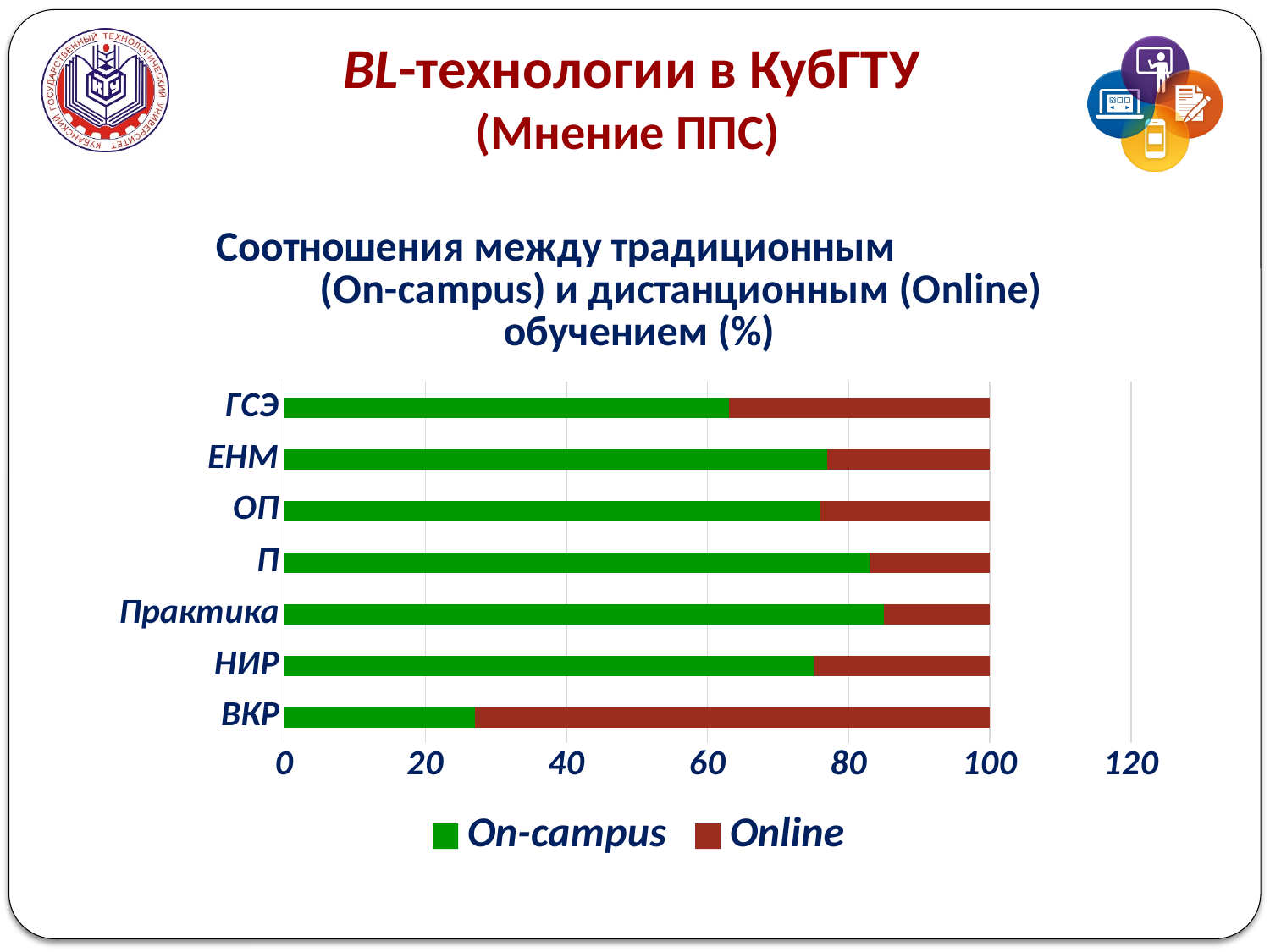
How many series does the chart legend list? 2 What is the total of the stacked bar for ЕНМ? 100 Is the On-campus value for ГСЭ greater or less than 60? greater Which colour represents the On-campus series in the chart? Green Is the On-campus value for НИР greater or less than 80? less What kind of chart is shown on the slide? Stacked bar chart Which category has the highest Online share? ВКР How many categories are shown on the vertical axis of the chart? 7 Is the On-campus value for ВКР greater or less than 40? less Which category has the lowest On-campus share? ВКР Which has the larger On-campus share, ГСЭ or ВКР? ГСЭ